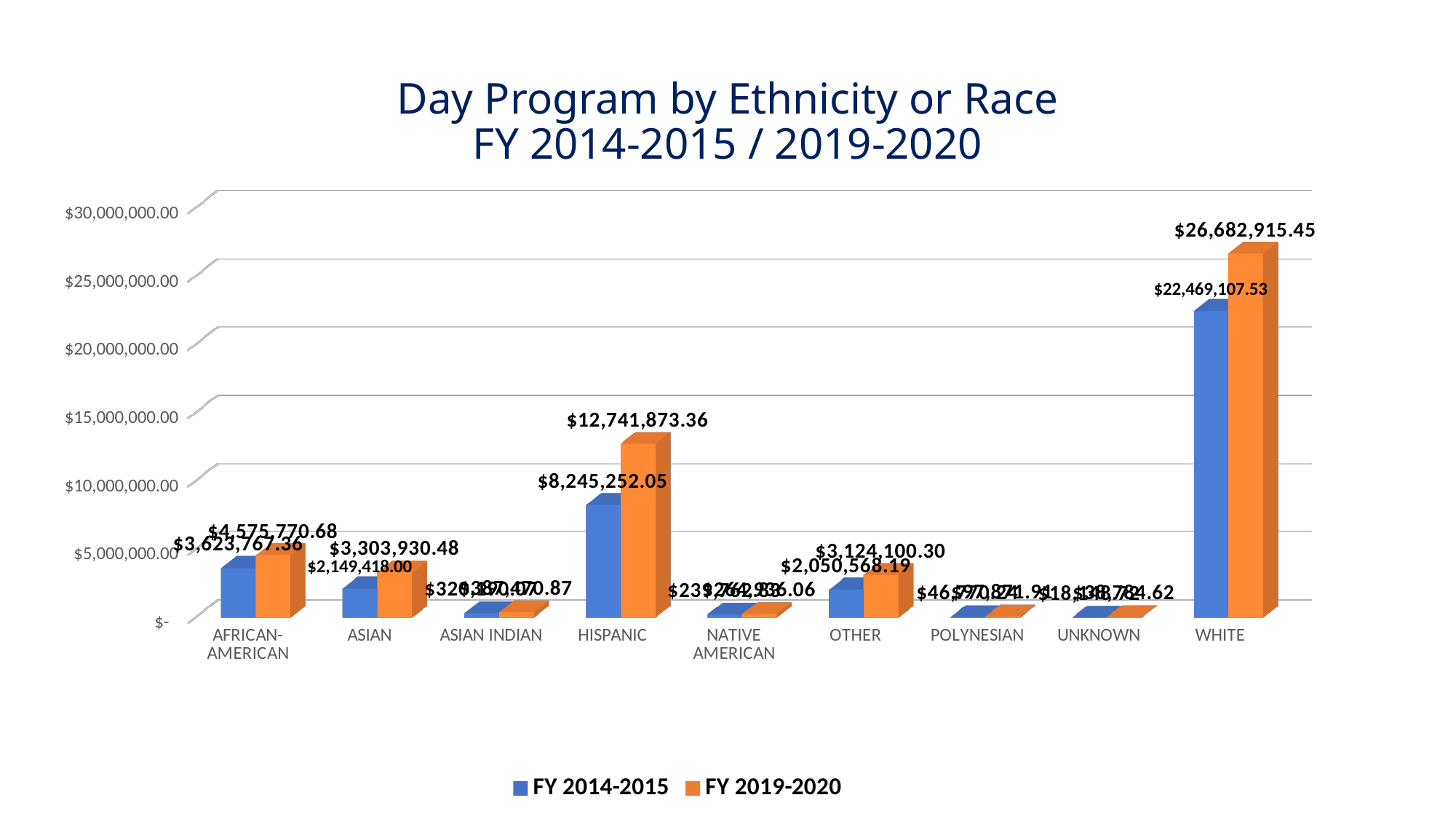
Is the FY 2019-2020 value for White greater or less than $25,000,000.00? greater Which category has the highest FY 2019-2020 value? White What is the FY 2019-2020 value for Asian? $3,303,930.48 Which is larger for African-American: the FY 2014-2015 value or the FY 2019-2020 value? FY 2019-2020 What is the difference between the FY 2019-2020 and FY 2014-2015 values for Hispanic? $4,496,621.31 What kind of chart is shown on the slide? bar chart What is the FY 2019-2020 value for White? $26,682,915.45 What is the FY 2014-2015 value for Other? $2,050,568.19 What is the difference between the FY 2019-2020 and FY 2014-2015 values for White? $4,213,807.92 How many series does the legend list? 2 How many ethnicity or race categories are shown on the x axis? 9 What is the FY 2014-2015 value for Hispanic? $8,245,252.05